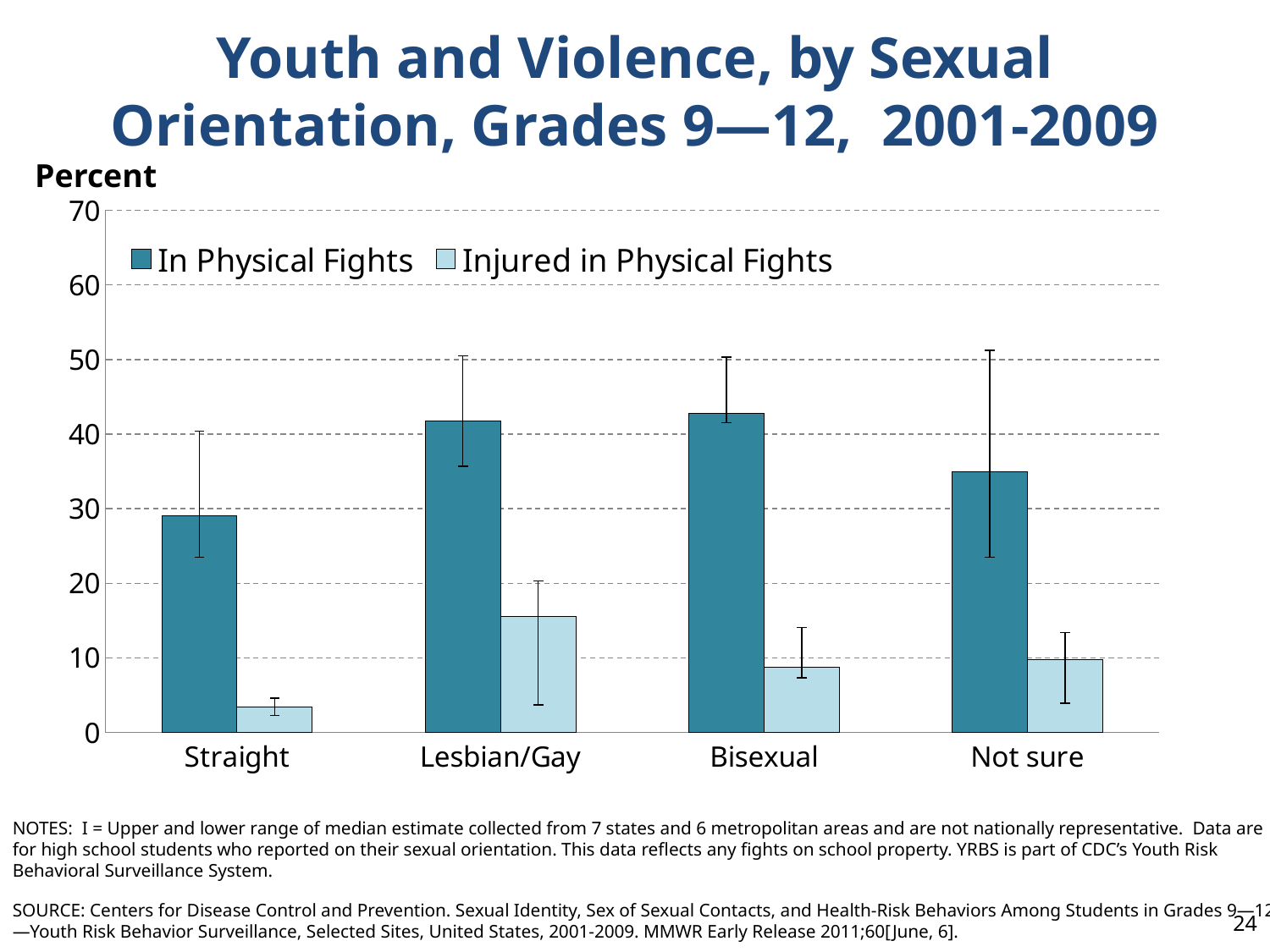
What is the label on the y axis of the chart? Percent How many sexual orientation categories are shown on the x axis? 4 Is the Injured in Physical Fights value for Lesbian/Gay greater or less than 10? greater Is the In Physical Fights value for Lesbian/Gay greater or less than 40? greater Is the In Physical Fights value for Not sure greater or less than 40? less How many series does the legend list? 2 For In Physical Fights, which is larger: Not sure or Straight? Not sure Which category has the lowest value for Injured in Physical Fights? Straight What kind of chart is shown on the slide? bar chart Which category has the highest value for Injured in Physical Fights? Lesbian/Gay Which category has the lowest value for In Physical Fights? Straight